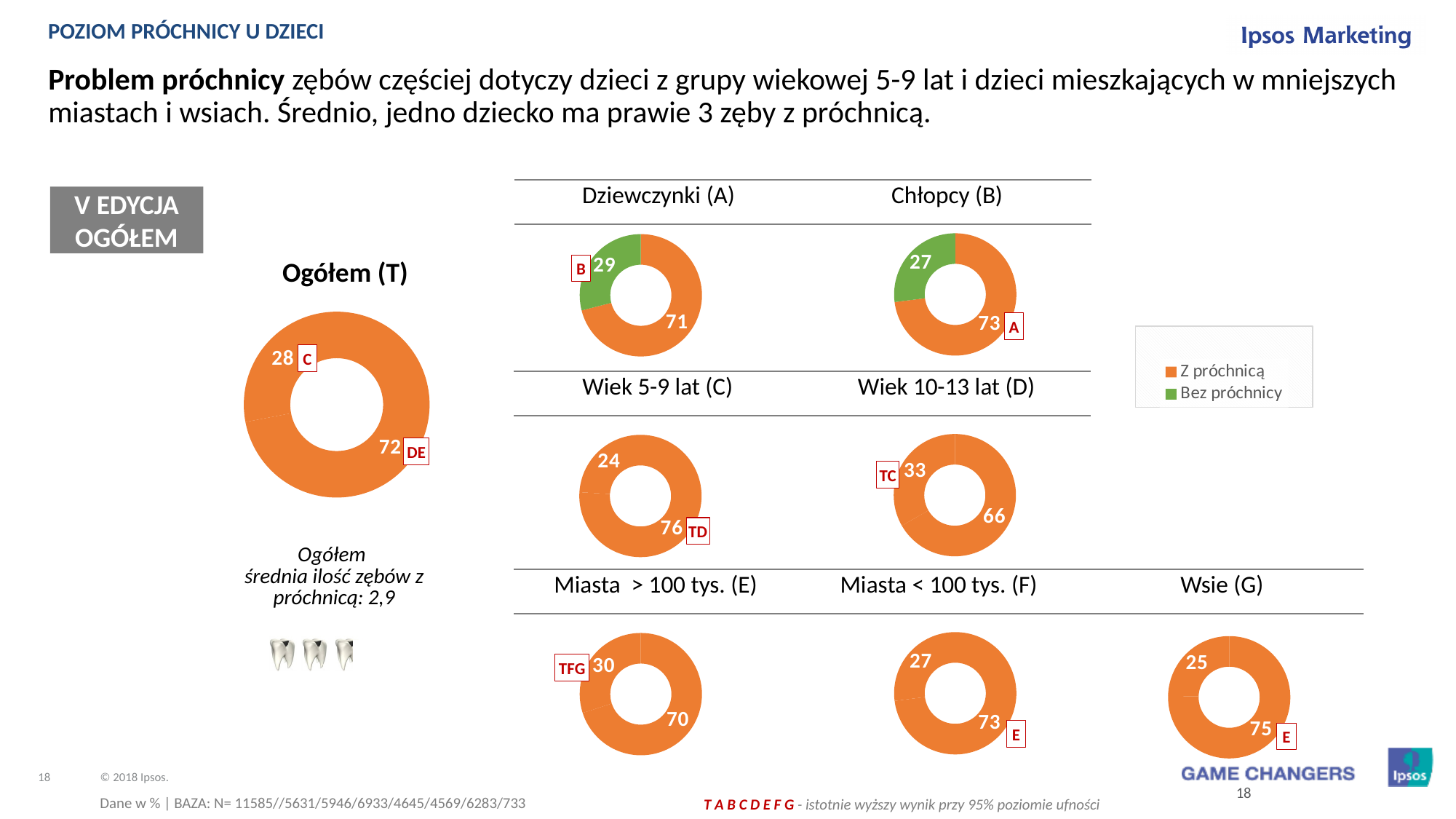
In the 'Wiek 5-9 lat (C)' chart, what is the value for 'Z próchnicą'? 76 How many series does the legend list? 2 In the 'Ogółem (T)' chart, what is the value for 'Z próchnicą'? 72 In the 'Wsie (G)' chart, what is the value for 'Z próchnicą'? 75 What is the difference between the 'Z próchnicą' value in the 'Wiek 5-9 lat (C)' chart and the 'Z próchnicą' value in the 'Wiek 10-13 lat (D)' chart? 10 In the legend, which colour represents 'Bez próchnicy'? Green In the 'Ogółem (T)' chart, what is the value for 'Bez próchnicy'? 28 What kind of chart is the 'Ogółem (T)' chart? Donut chart In the 'Wiek 10-13 lat (D)' chart, what is the value for 'Bez próchnicy'? 33 Which is larger: the 'Z próchnicą' value in the 'Miasta > 100 tys. (E)' chart or in the 'Miasta < 100 tys. (F)' chart? Miasta < 100 tys. (F) In the 'Dziewczynki (A)' chart, what is the value for 'Bez próchnicy'? 29 In the 'Chłopcy (B)' chart, what is the value for 'Z próchnicą'? 73